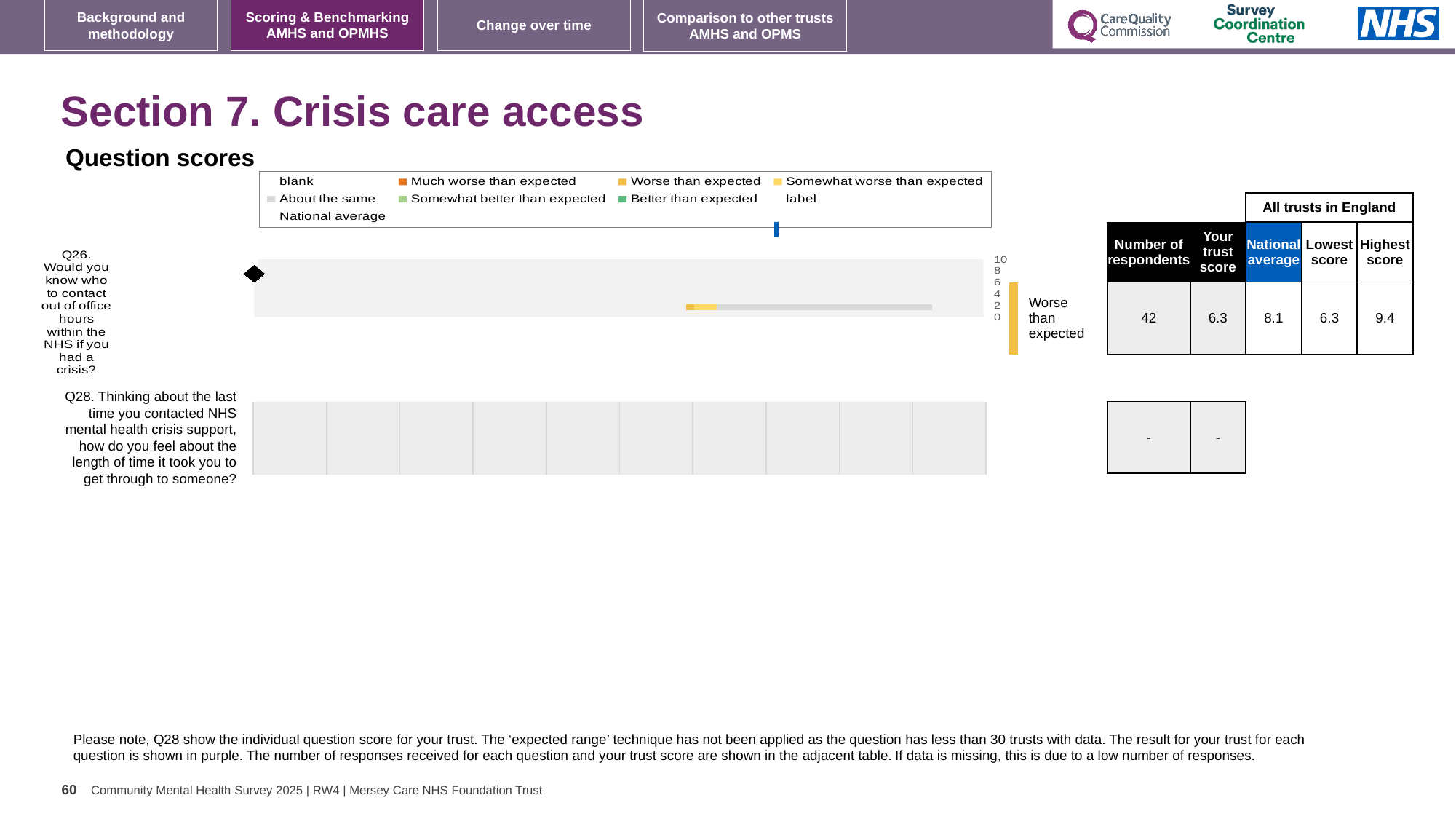
How many respondents are shown for Q26? 42 What kind of chart is used to show the question scores on this slide? bar chart Which question on the chart is labelled 'Worse than expected'? Q26 For Q26, which is larger: the trust score or the national average? national average What is the highest score across all trusts in England for Q26? 9.4 What is the difference between the national average and the trust score for Q26? 1.8 What colour is used in the legend for 'Much worse than expected'? orange What is the lowest score across all trusts in England for Q26? 6.3 What is the trust score for Q26 shown next to the chart? 6.3 What is the difference between the highest score and the lowest score for Q26? 3.1 What is the national average for Q26 shown next to the chart? 8.1 What is the maximum value shown on the chart's score axis? 10